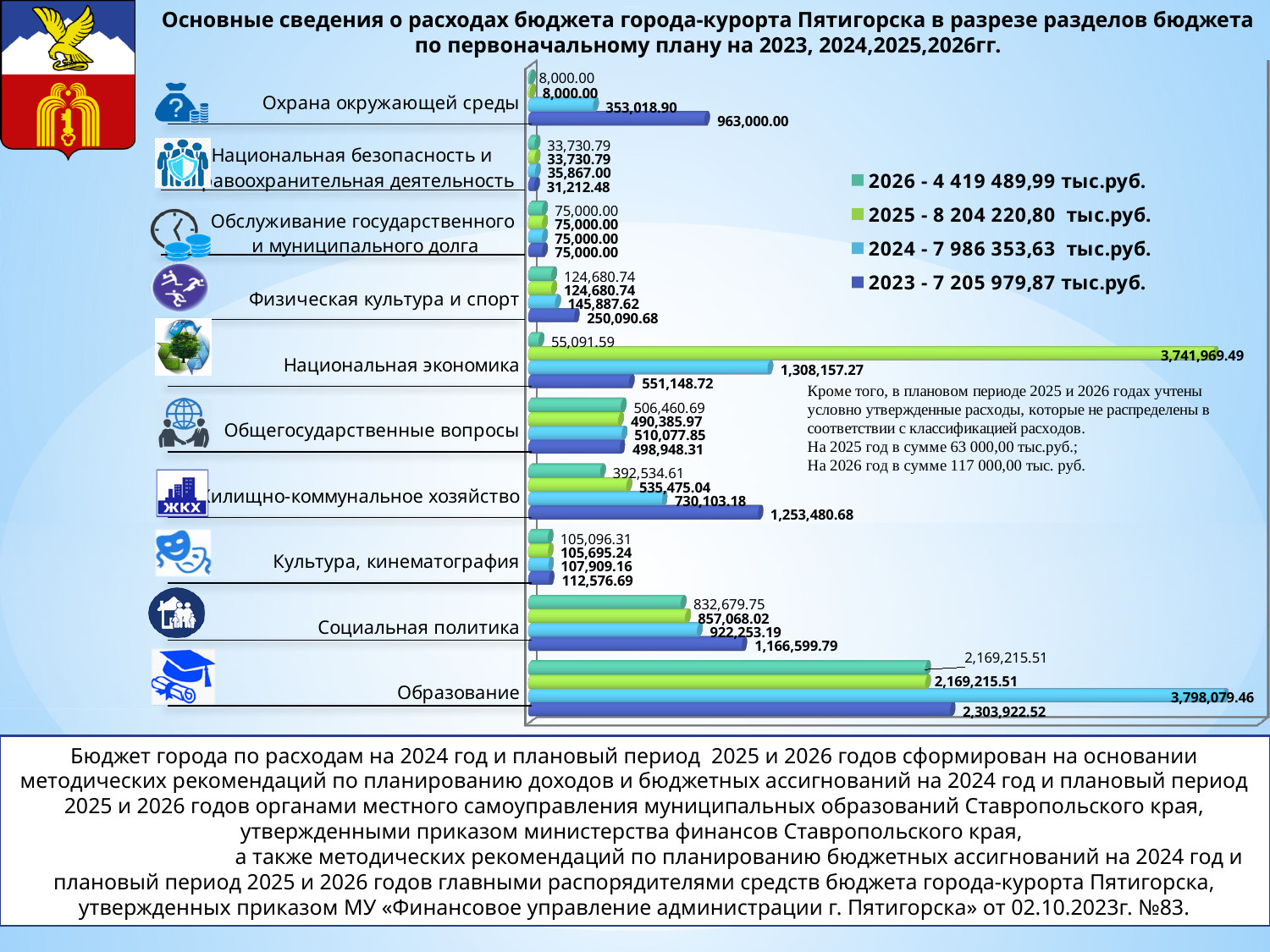
What is the 2024 value for Образование? 3,798,079.46 According to the legend, what is the total expenditure for 2025? 8 204 220,80 тыс.руб. Which is larger for Национальная экономика: the 2024 value or the 2023 value? 2024 Which budget section has the highest 2024 value? Образование What is the 2023 value for Жилищно-коммунальное хозяйство? 1,253,480.68 What is the 2025 value for Национальная экономика? 3,741,969.49 Which budget section has the lowest 2026 value? Охрана окружающей среды How many budget sections (categories) are shown on the chart? 10 What is the difference between the 2023 and 2024 values for Социальная политика? 244,346.60 How many series does the chart legend list? 4 What is the 2023 value for Охрана окружающей среды? 963,000.00 What kind of chart is shown on the slide? Bar chart